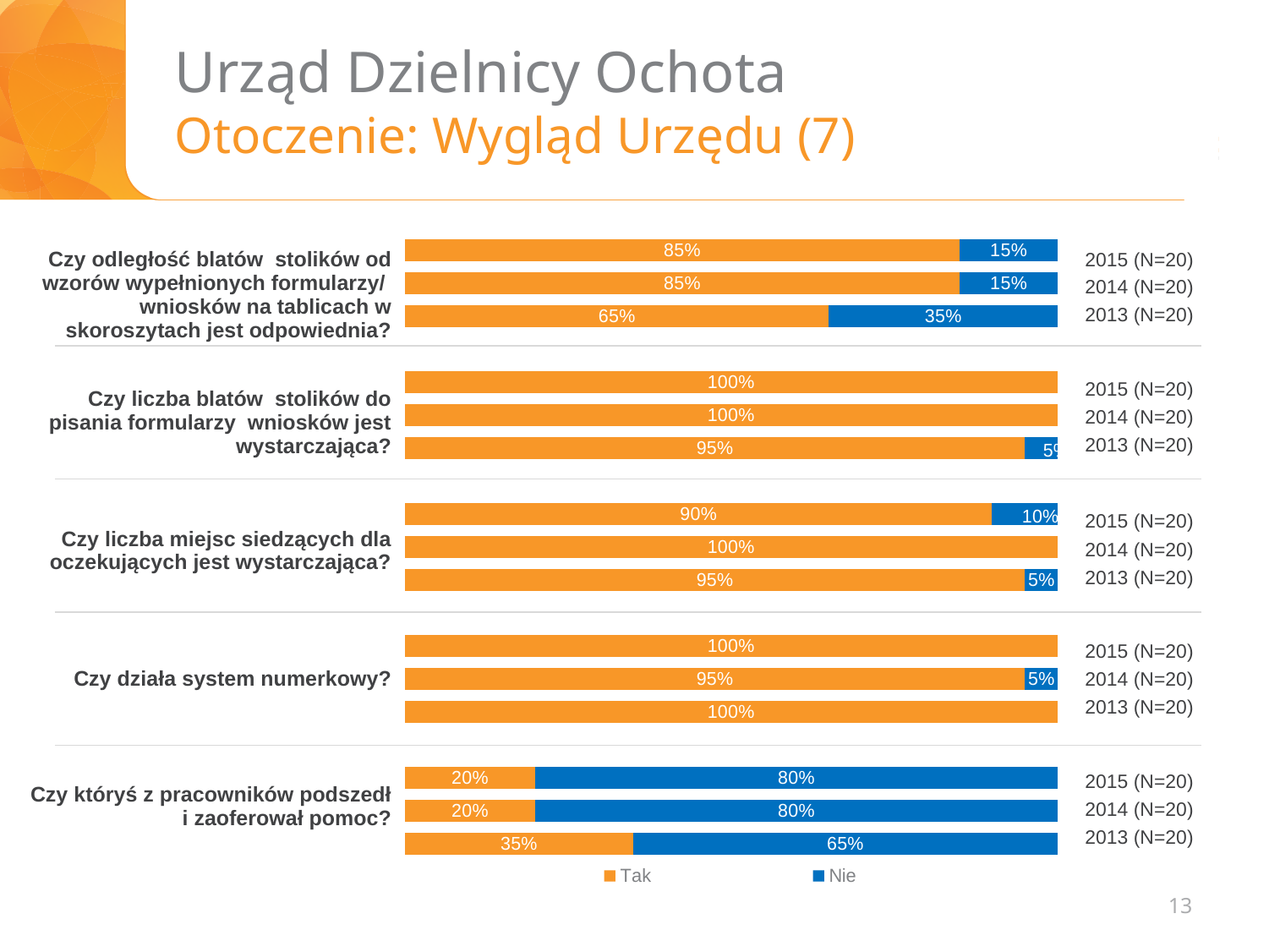
How many series does the legend list? 2 In the chart for "Czy odległość blatów stolików od wzorów wypełnionych formularzy/wniosków na tablicach w skoroszytach jest odpowiednia?", what is the "Tak" value for 2013 (N=20)? 65% What type of chart is used on the slide? Stacked bar chart In the chart for "Czy któryś z pracowników podszedł i zaoferował pomoc?", is the "Tak" value or the "Nie" value larger for 2015 (N=20)? Nie In the chart for "Czy liczba miejsc siedzących dla oczekujących jest wystarczająca?", which year has the highest "Tak" value? 2014 (N=20) In the chart for "Czy liczba blatów stolików do pisania formularzy wniosków jest wystarczająca?", what is the "Tak" value for 2013 (N=20)? 95% In the chart for "Czy odległość blatów stolików od wzorów wypełnionych formularzy/wniosków na tablicach w skoroszytach jest odpowiednia?", what is the difference between the "Tak" values for 2015 (N=20) and 2013 (N=20)? 20% In the chart for "Czy liczba miejsc siedzących dla oczekujących jest wystarczająca?", what is the "Nie" value for 2015 (N=20)? 10% In the chart for "Czy działa system numerkowy?", which year has the lowest "Tak" value? 2014 (N=20) In the chart for "Czy któryś z pracowników podszedł i zaoferował pomoc?", what is the "Nie" value for 2013 (N=20)? 65% In the chart for "Czy odległość blatów stolików od wzorów wypełnionych formularzy/wniosków na tablicach w skoroszytach jest odpowiednia?", what is the "Nie" value for 2015 (N=20)? 15% In the chart for "Czy któryś z pracowników podszedł i zaoferował pomoc?", what is the difference between the "Nie" value for 2015 (N=20) and the "Nie" value for 2013 (N=20)? 15%